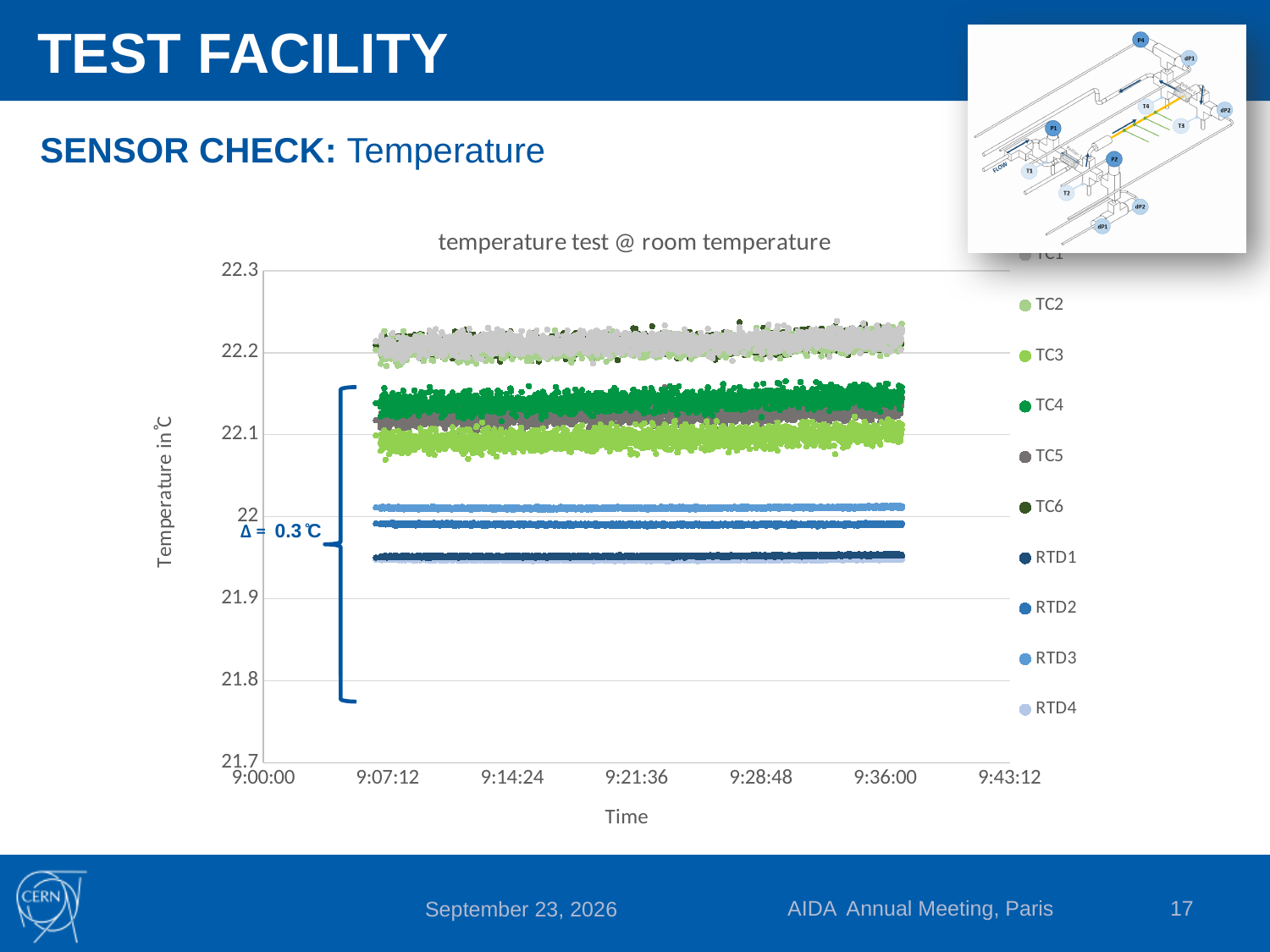
Is the value for RTD2 greater or less than 22.1? less Is the value for RTD4 greater or less than 22? less Which series has the larger values, TC4 or RTD1? TC4 What temperature spread (Δ) is annotated on the chart? 0.3 °C How many series does the chart legend list? 10 Is the value for TC4 greater or less than 22.2? less Which series has the larger values, TC2 or RTD2? TC2 What is the label of the y axis of the chart? Temperature in °C What is the title of the chart? temperature test @ room temperature What kind of chart is shown on the slide? scatter chart